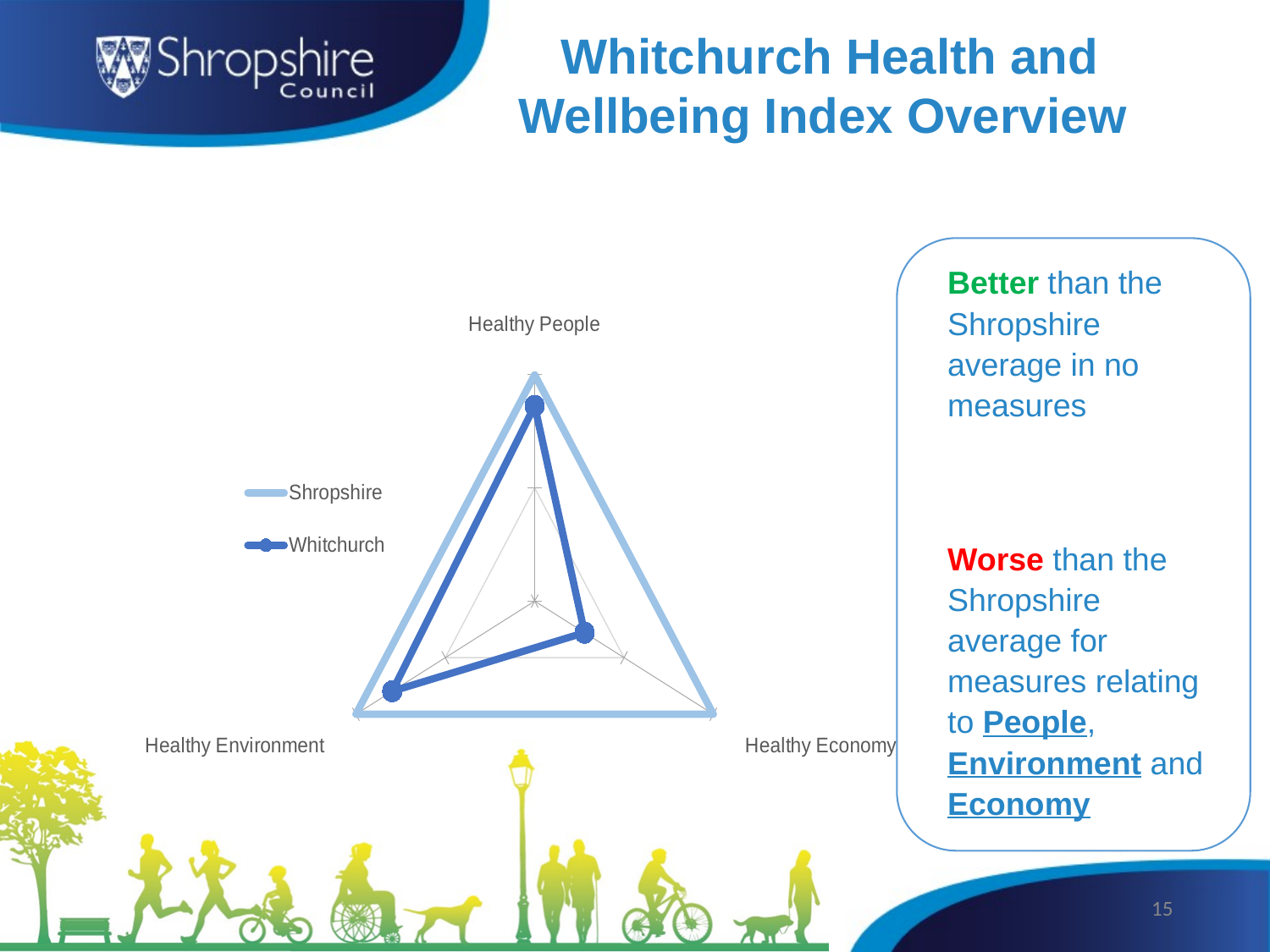
Which series has the larger value for Healthy Environment, Shropshire or Whitchurch? Shropshire Does Whitchurch exceed Shropshire on any of the three axes? No On which axis is the Whitchurch value lowest? Healthy Economy How many series does the chart legend list? 2 Which series has the larger value for Healthy Economy, Shropshire or Whitchurch? Shropshire Which two series are shown in the chart legend? Shropshire and Whitchurch How many axes (categories) does the radar chart have? 3 What kind of chart is shown on the slide? Radar chart What are the three categories plotted on the radar chart? Healthy People, Healthy Environment, Healthy Economy